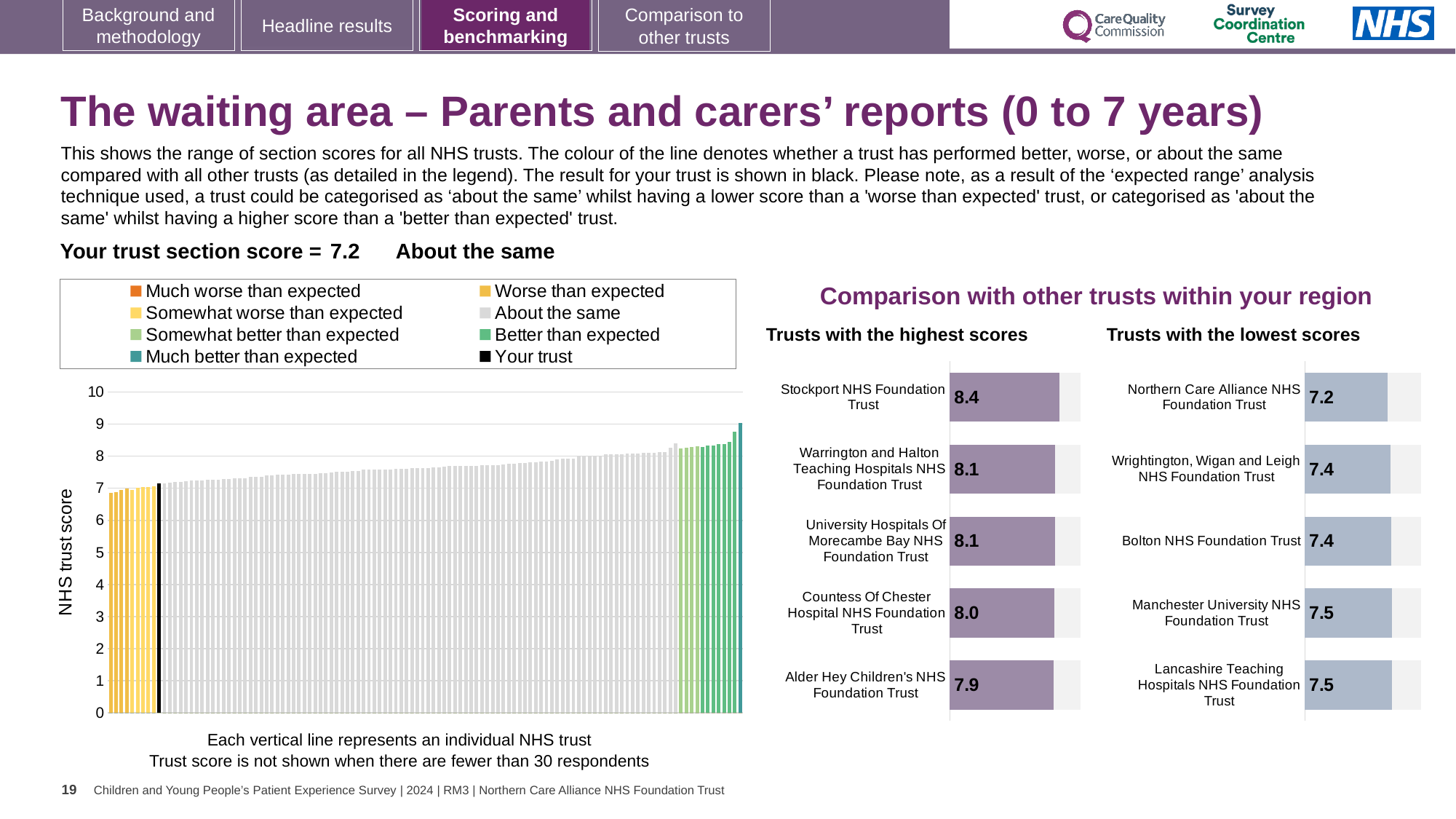
In the 'Trusts with the highest scores' chart, which trust has the highest score? Stockport NHS Foundation Trust How many trusts are listed in the 'Trusts with the lowest scores' chart? 5 In the 'Trusts with the lowest scores' chart, what is the score for Bolton NHS Foundation Trust? 7.4 How many entries does the legend of the large chart on the left list? 8 In the 'Trusts with the highest scores' chart, what is the difference between the scores of Stockport NHS Foundation Trust and Alder Hey Children's NHS Foundation Trust? 0.5 In the 'Trusts with the highest scores' chart, what is the score for Stockport NHS Foundation Trust? 8.4 In the large chart on the left showing NHS trust scores, is the value of the highest bar greater or less than 8? greater In the 'Trusts with the highest scores' chart, which has the larger score: Countess Of Chester Hospital NHS Foundation Trust or Warrington and Halton Teaching Hospitals NHS Foundation Trust? Warrington and Halton Teaching Hospitals NHS Foundation Trust In the 'Trusts with the lowest scores' chart, what is the difference between the scores of Manchester University NHS Foundation Trust and Northern Care Alliance NHS Foundation Trust? 0.3 In the 'Trusts with the highest scores' chart, what is the score for Alder Hey Children's NHS Foundation Trust? 7.9 In the 'Trusts with the lowest scores' chart, which trust has the lowest score? Northern Care Alliance NHS Foundation Trust In the large chart on the left showing NHS trust scores, do the values rise or fall from left to right? rise